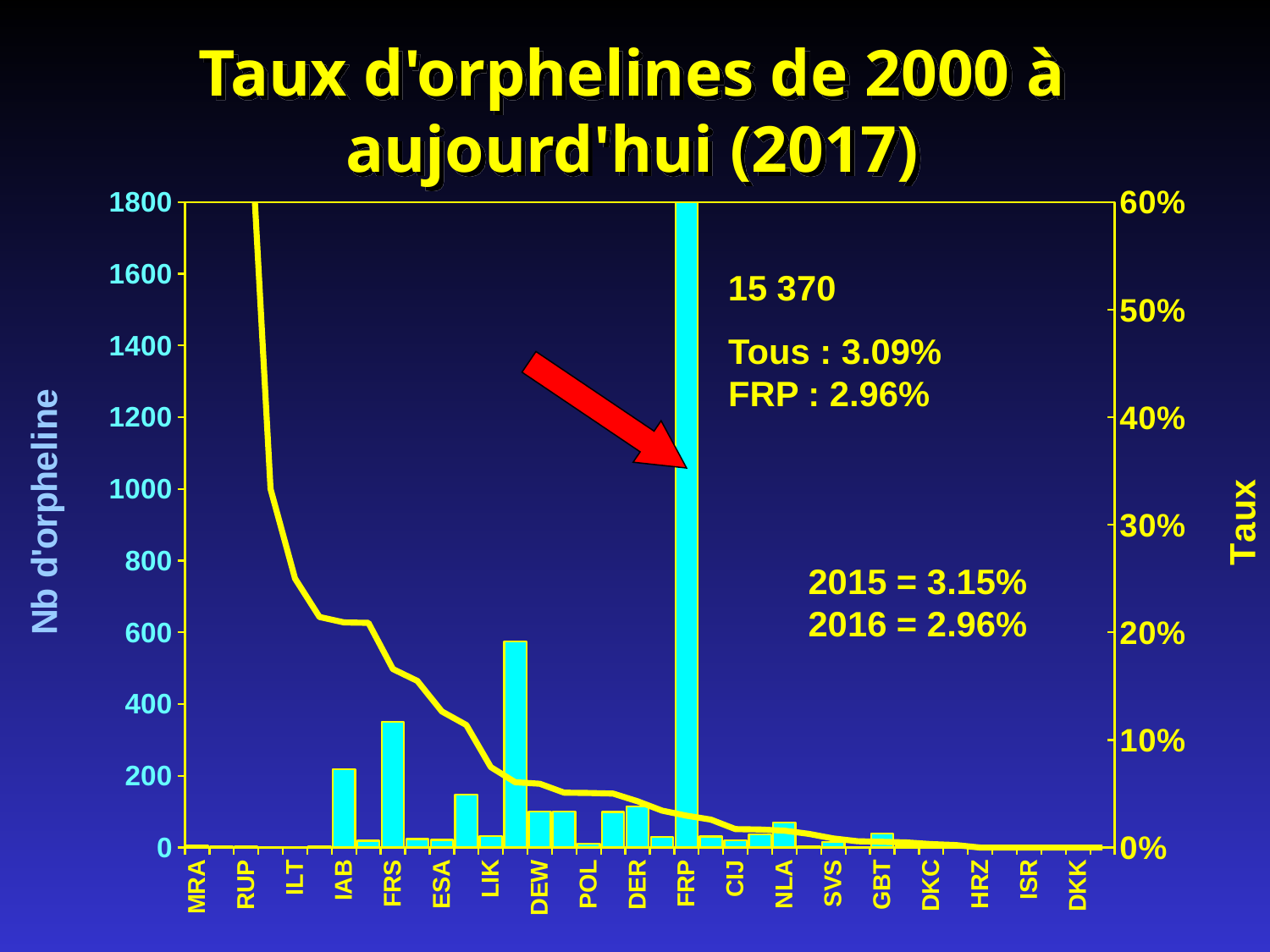
Which category has the tallest bar? FRP What is the title of the chart? Taux d'orphelines de 2000 à aujourd'hui (2017) Does the yellow line (Taux) rise or fall from left to right along the x axis? It falls What is the rate (Taux) given for FRP in the annotation? 2.96% Is the bar for DEW greater or less than 400? less What rate is given for 2015 on the slide? 3.15% Is the bar for FRS greater or less than 200? greater What is the rate given for 'Tous' in the annotation? 3.09% Which bar is taller, FRS or IAB? FRS What value is annotated next to the FRP bar? 15 370 What is the label of the right-hand vertical axis? Taux What kind of chart is shown on the slide? A bar chart combined with a line